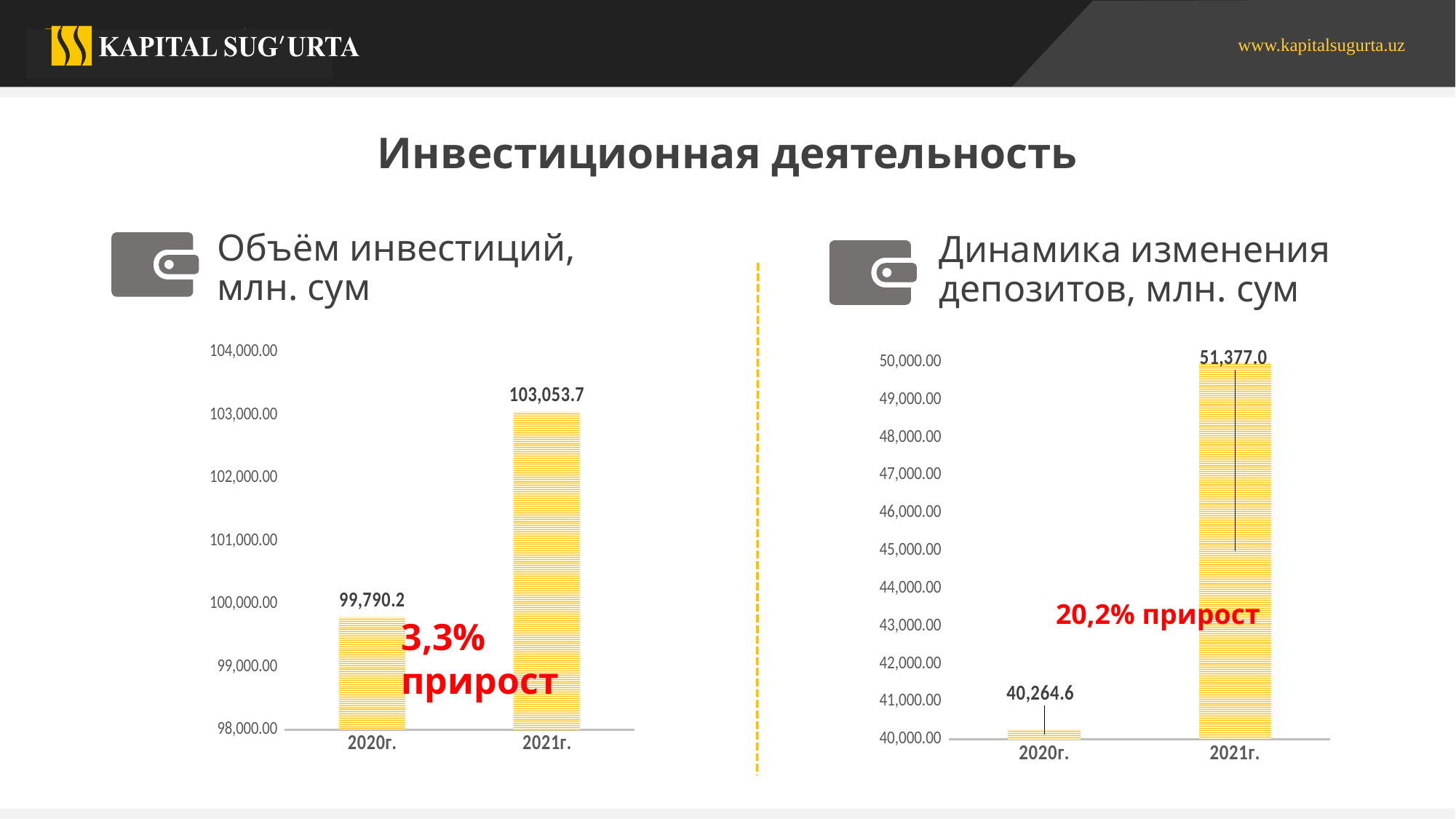
What percentage growth is annotated in red on the right chart (Динамика изменения депозитов, млн. сум)? 20,2% прирост In the left chart (Объём инвестиций, млн. сум), what is the difference between the 2021г. and 2020г. values? 3,263.5 In the left chart (Объём инвестиций, млн. сум), what is the value for 2021г.? 103,053.7 In the left chart (Объём инвестиций, млн. сум), which year has the higher value? 2021г. In the right chart (Динамика изменения депозитов, млн. сум), is the value for 2021г. greater or less than 50,000.00? greater In the right chart (Динамика изменения депозитов, млн. сум), what is the value for 2021г.? 51,377.0 In the right chart (Динамика изменения депозитов, млн. сум), what is the value for 2020г.? 40,264.6 How many categories are shown on the x axis of the left chart (Объём инвестиций, млн. сум)? 2 In the right chart (Динамика изменения депозитов, млн. сум), what is the difference between the 2021г. and 2020г. values? 11,112.4 What kind of chart is the right chart (Динамика изменения депозитов, млн. сум)? bar chart In the left chart (Объём инвестиций, млн. сум), what is the value for 2020г.? 99,790.2 In the right chart (Динамика изменения депозитов, млн. сум), which year has the lower value? 2020г.